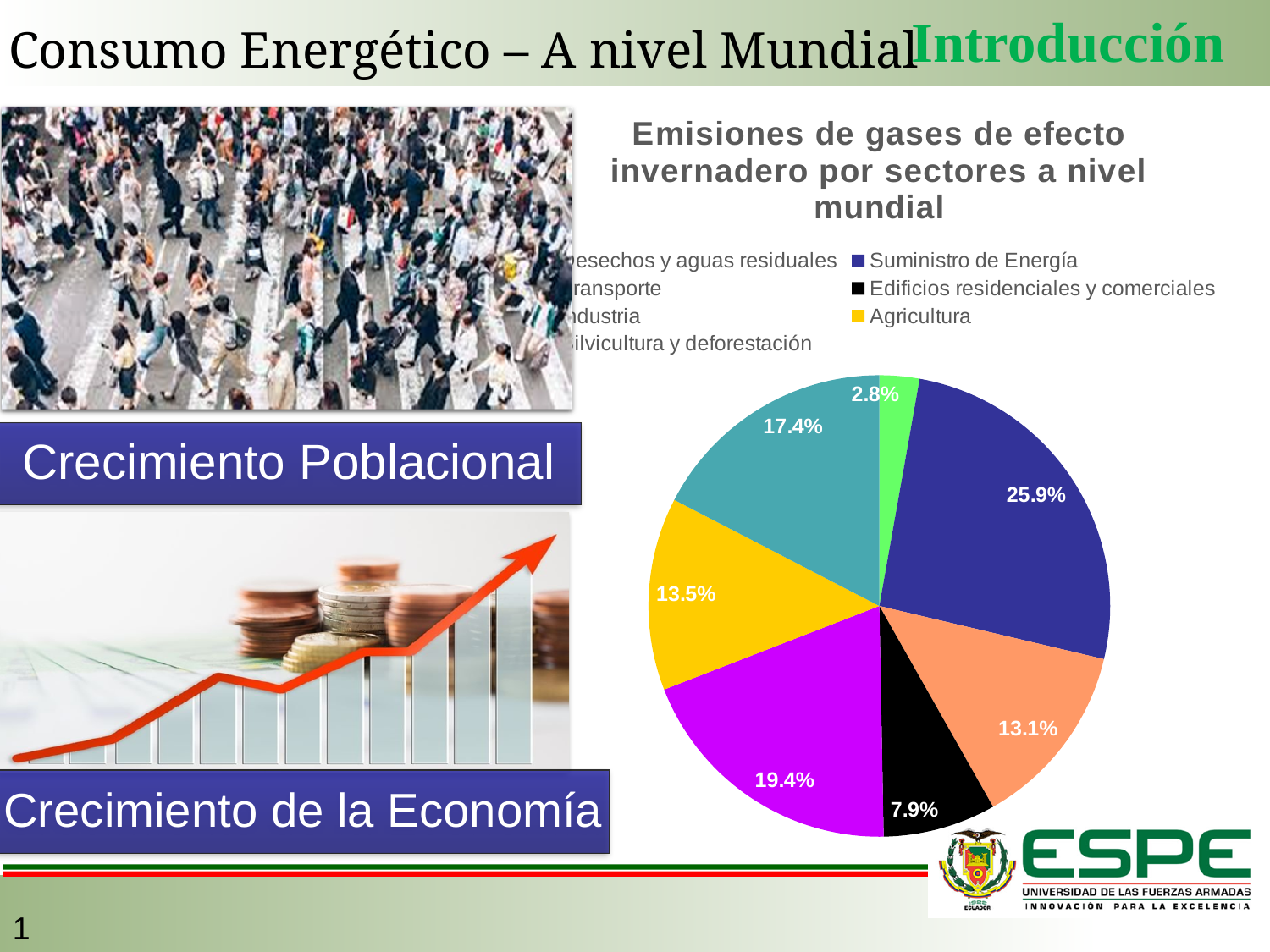
Which sector has the largest slice in the pie chart? Suministro de Energía In the pie chart, what percentage is shown for Agricultura? 13.5% What is the title of the pie chart on the slide? Emisiones de gases de efecto invernadero por sectores a nivel mundial In the pie chart, what percentage is shown for Edificios residenciales y comerciales? 7.9% What is the smallest percentage labelled on the pie chart? 2.8% In the pie chart, which is larger: Agricultura or Edificios residenciales y comerciales? Agricultura How many slices does the pie chart have? 7 In the pie chart, how many percentage points larger is Suministro de Energía than Agricultura? 12.4 percentage points What type of chart is shown under the title 'Emisiones de gases de efecto invernadero por sectores a nivel mundial'? Pie chart What is the difference between the largest and smallest slices of the pie chart? 23.1 percentage points In the pie chart, what percentage is shown for Suministro de Energía? 25.9% How many entries does the legend of the pie chart list? 7